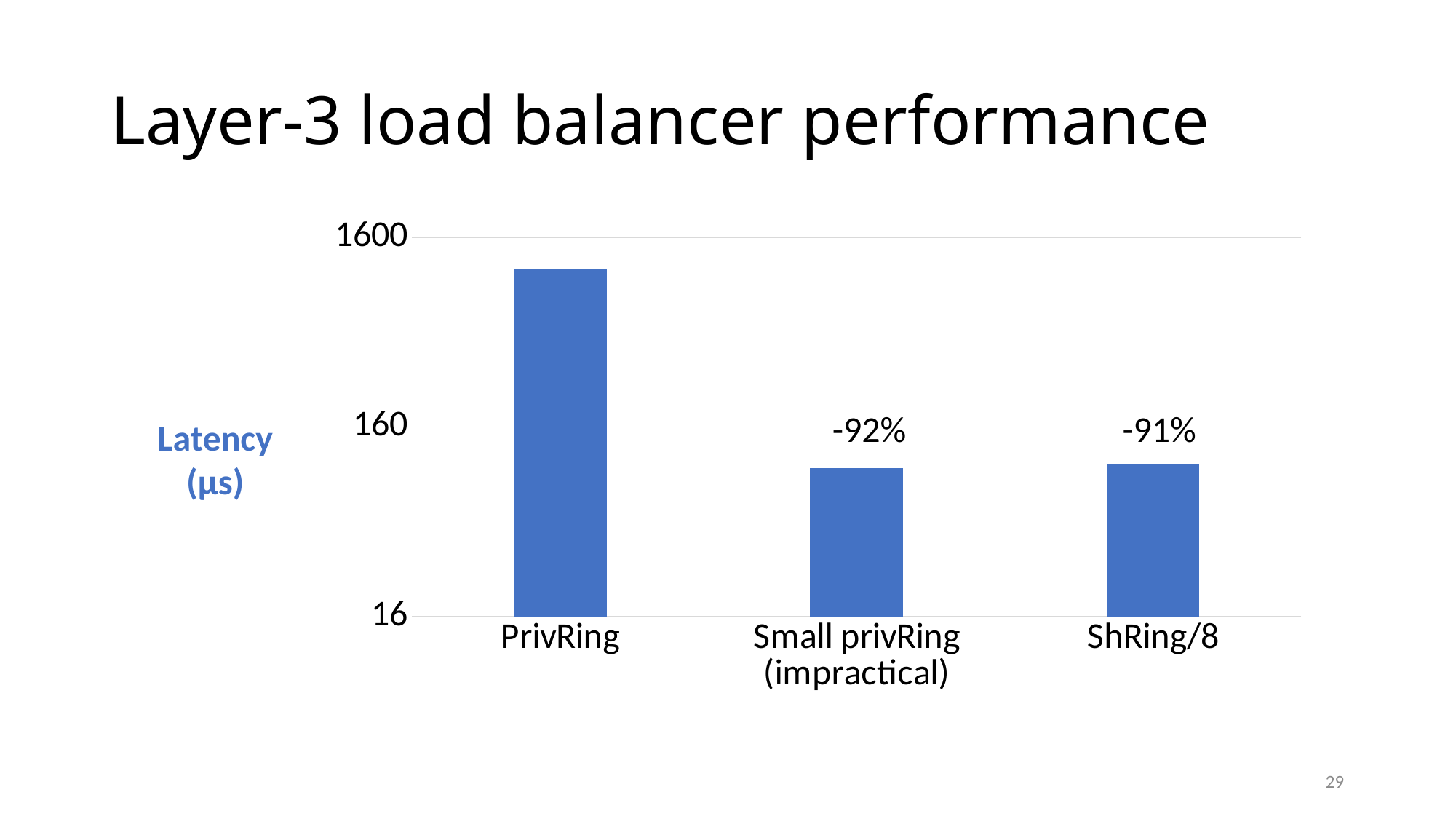
Which has the larger latency, PrivRing or ShRing/8? PrivRing What is the label of the y axis? Latency (µs) Is the latency for PrivRing greater or less than 1600? less Is the latency for PrivRing greater or less than 160? greater What is the title of the slide? Layer-3 load balancer performance Is the latency for ShRing/8 greater or less than 160? less What percentage label is printed above the ShRing/8 bar? -91% Which category has the lowest latency? Small privRing (impractical) How many categories are plotted on the x axis? 3 Which category has the highest latency? PrivRing What kind of chart is shown on the slide? bar chart What percentage label is printed above the Small privRing (impractical) bar? -92%